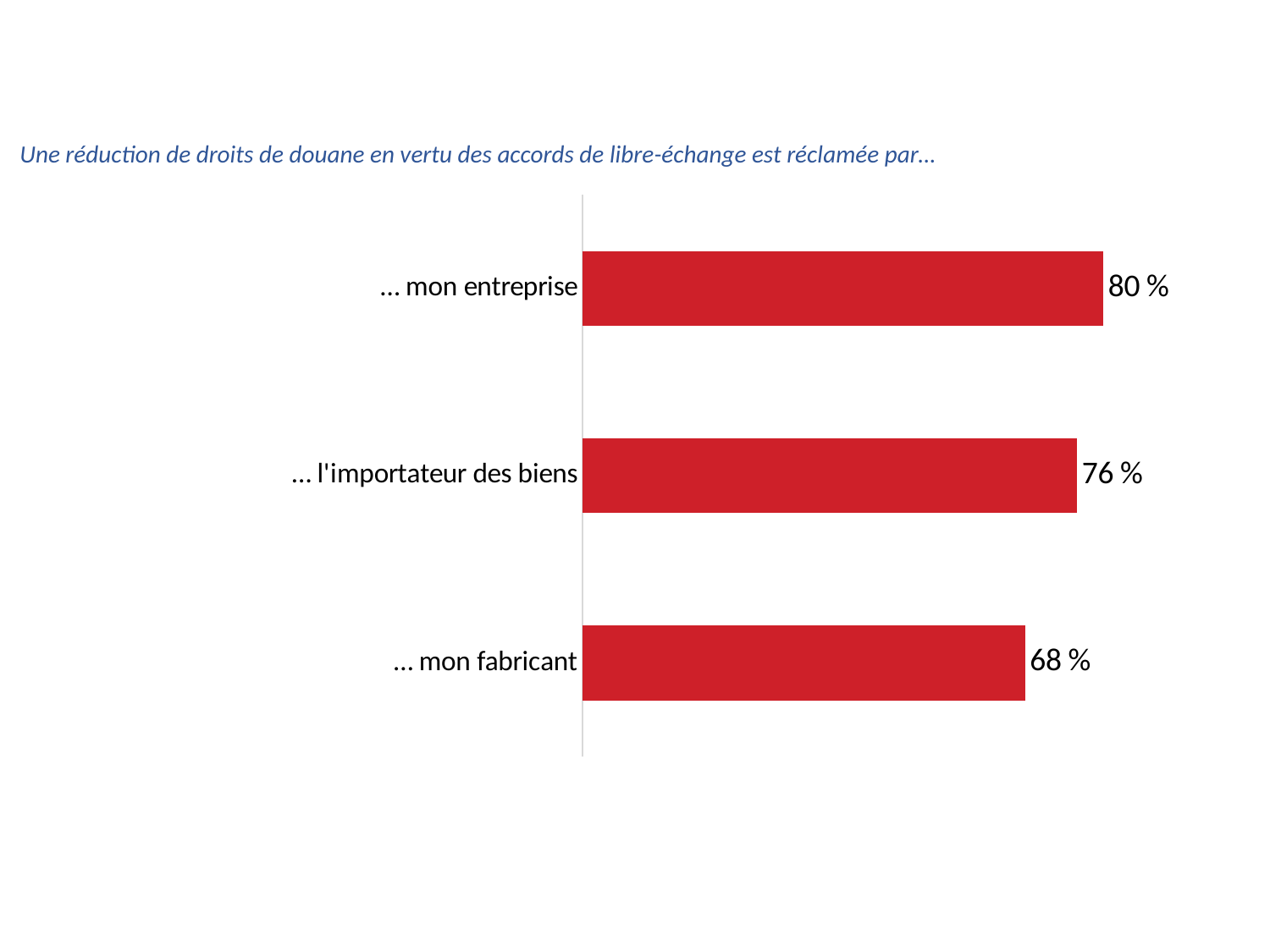
What is the title of the chart? Une réduction de droits de douane en vertu des accords de libre-échange est réclamée par… Which category has the highest value? … mon entreprise What is the difference between the values for "… l'importateur des biens" and "… mon fabricant"? 8 % What kind of chart is shown on the slide? Bar chart What is the value for "… l'importateur des biens"? 76 % Which is larger: the value for "… l'importateur des biens" or "… mon fabricant"? … l'importateur des biens What is the value for "… mon fabricant"? 68 % What colour are the bars in the chart? Red What is the difference between the values for "… mon entreprise" and "… mon fabricant"? 12 % What is the value for "… mon entreprise"? 80 % How many categories are shown in the chart? 3 Which category has the lowest value? … mon fabricant